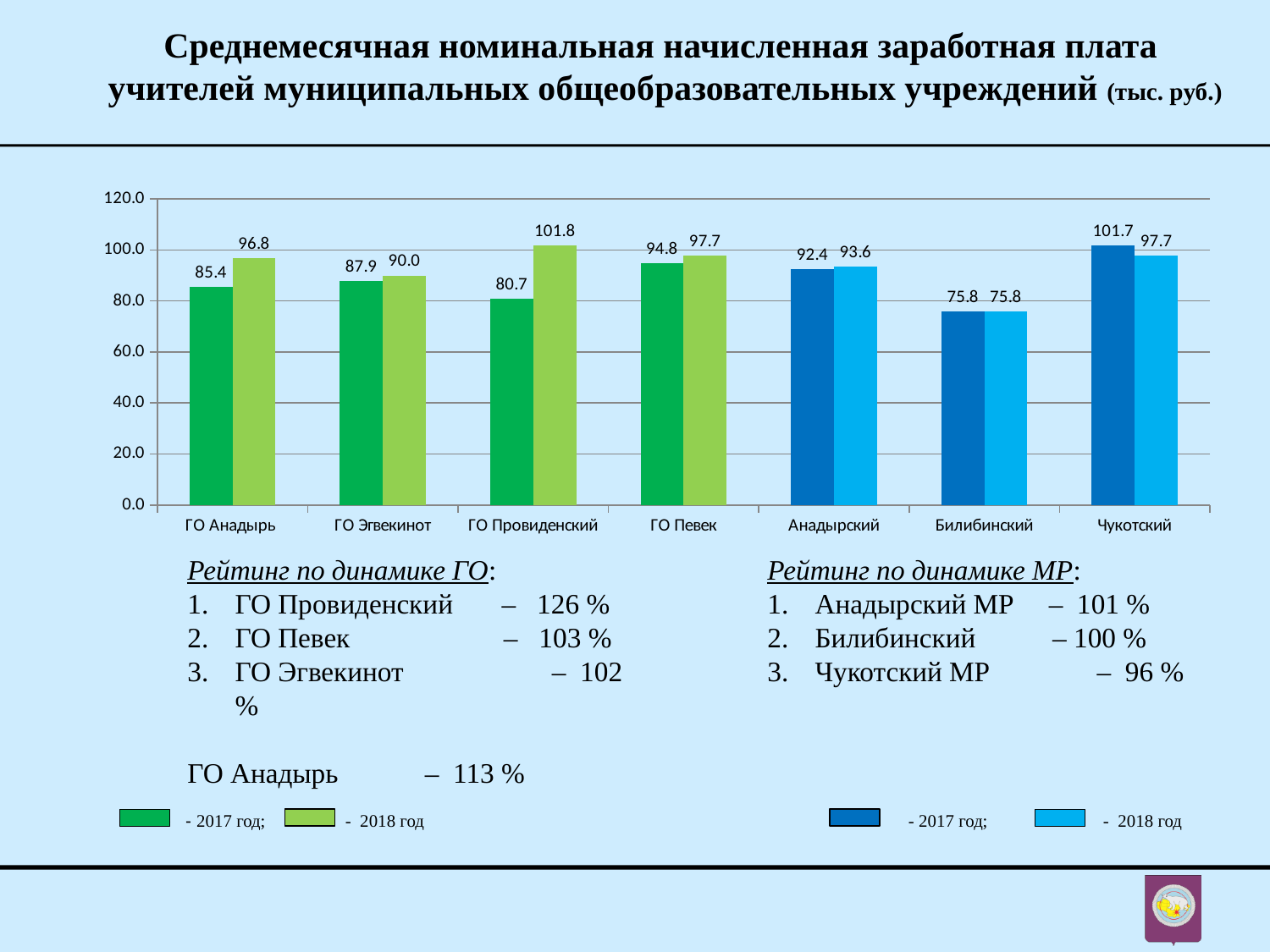
What is the difference between the 2018 and 2017 values for ГО Провиденский? 21.1 Which municipality has the lowest 2017 value? Билибинский How many years (series) does the chart compare for each municipality? 2 Which municipality has the highest 2018 value? ГО Провиденский Which colour represents the 2018 year for the ГО (green) group of bars? light green What type of chart is shown on the slide? bar chart How many municipalities (categories) are shown on the x axis of the chart? 7 Is the 2017 value for Билибинский greater or less than 80.0? less What is the 2018 value for Чукотский? 97.7 What is the 2018 value for ГО Провиденский? 101.8 What is the 2017 value for ГО Анадырь? 85.4 Which is larger for Чукотский: the 2017 value or the 2018 value? 2017 value